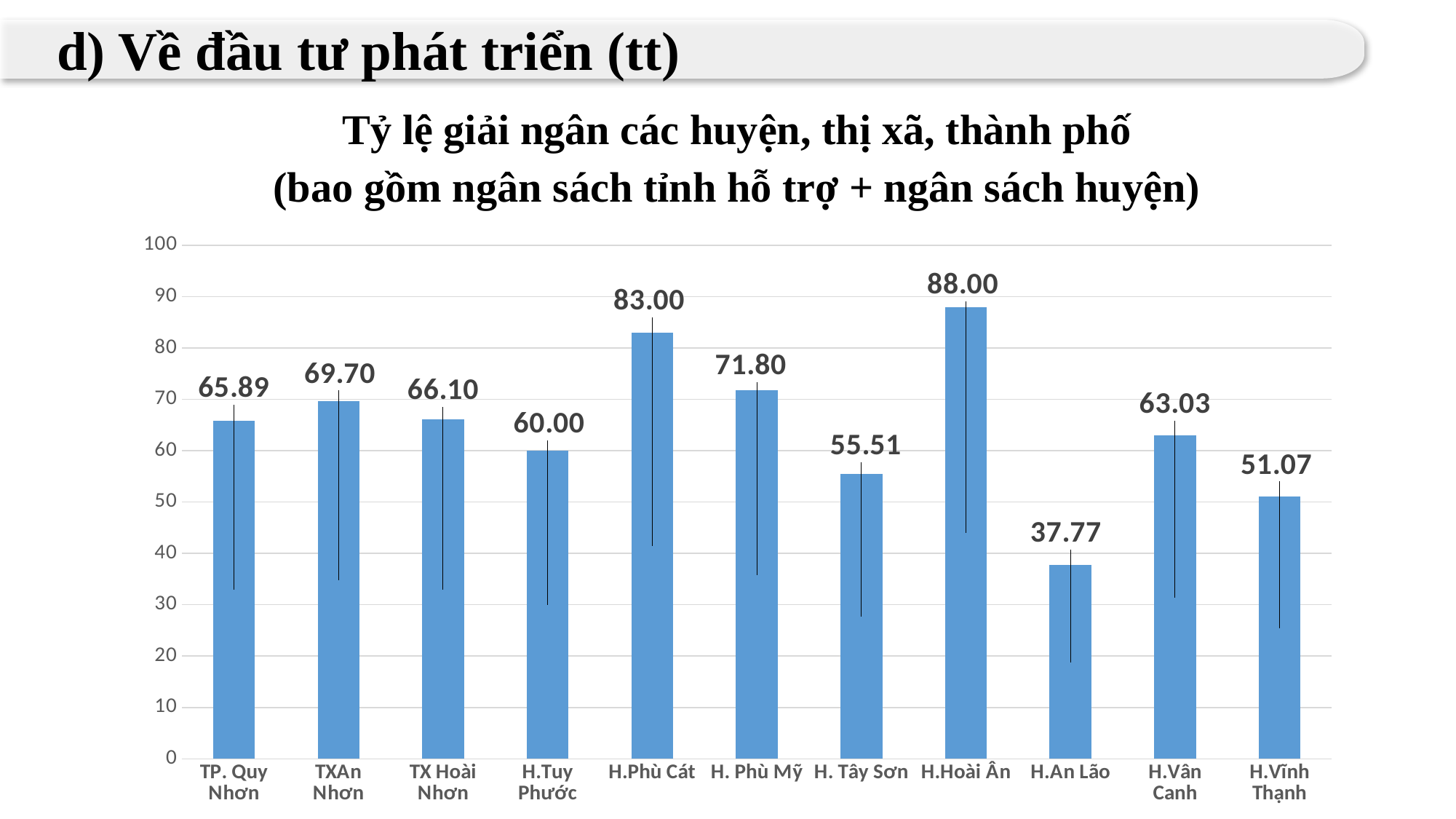
What is the difference between the values for H.Hoài Ân and H.An Lão? 50.23 What is the difference between the values for H. Phù Mỹ and H.Tuy Phước? 11.80 Which is larger, the value for TXAn Nhơn or the value for H.Vân Canh? TXAn Nhơn What is the value for H.Phù Cát? 83.00 Is the value for H. Tây Sơn greater or less than 60? less What kind of chart is shown on the slide? bar chart Which category has the lowest value? H.An Lão What is the value for TX Hoài Nhơn? 66.10 What is the maximum value shown on the vertical axis? 100 How many categories are shown on the x axis? 11 Which category has the highest value? H.Hoài Ân What is the value for H.An Lão? 37.77